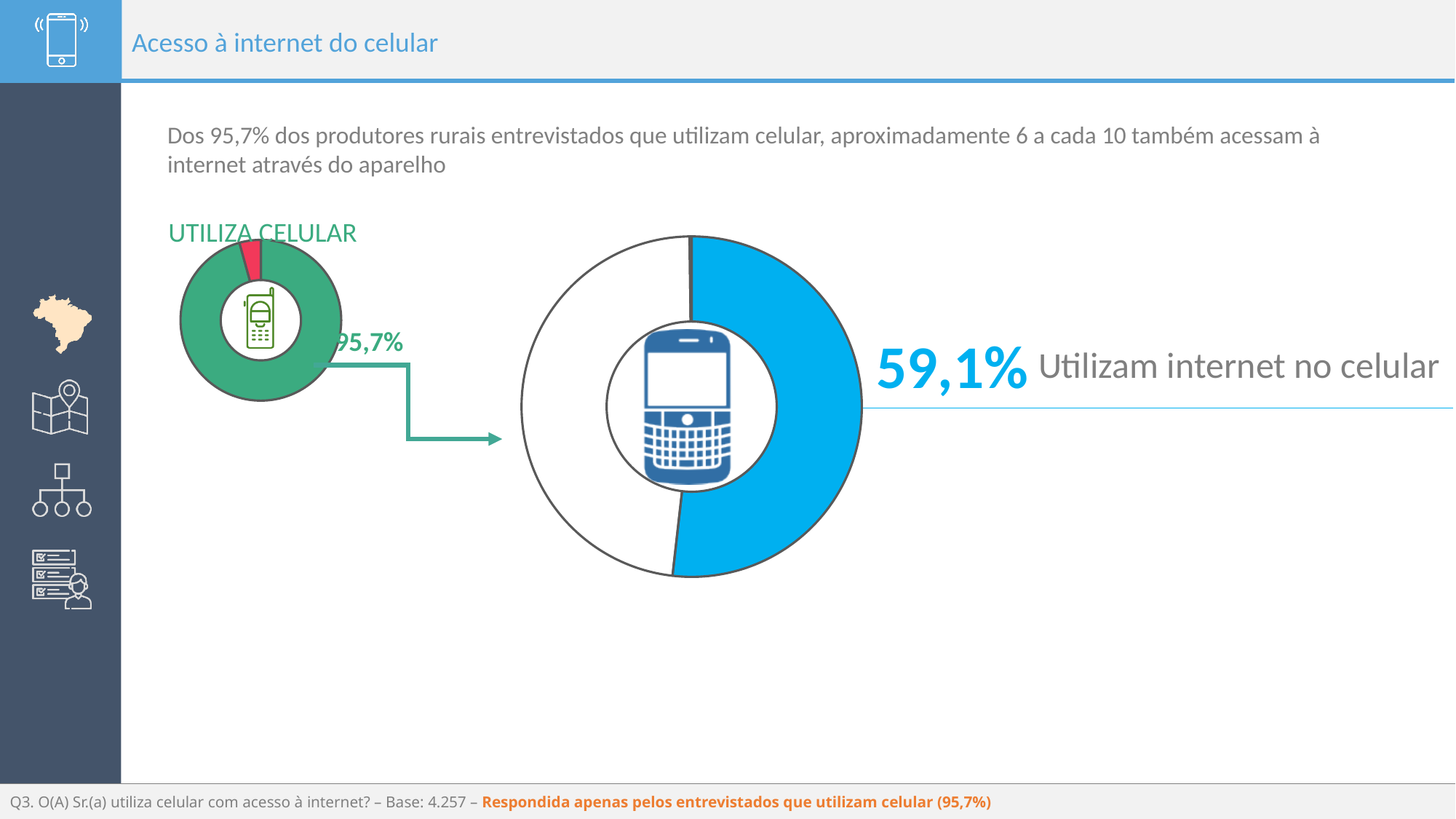
What kind of chart is the small chart titled 'UTILIZA CELULAR'? Donut (pie) chart How many slices does the small 'UTILIZA CELULAR' donut chart have? 2 In the large donut chart on the right, which slice is larger: the blue slice or the white slice? The blue slice What is the title of the small donut chart on the left? UTILIZA CELULAR What share of the large donut chart on the right does the blue slice represent? 59,1% What colour is the slice representing 59,1% in the large donut chart on the right? Blue In the large donut chart on the right, what percentage is shown for 'Utilizam internet no celular'? 59,1% What is the difference between the 95,7% shown in the 'UTILIZA CELULAR' chart and the 59,1% shown in the large chart on the right? 36,6% In the small donut chart titled 'UTILIZA CELULAR', what percentage is shown for the green slice? 95,7% How many slices does the large donut chart on the right have? 2 What kind of chart is the large chart on the right of the slide? Donut (pie) chart Which value is larger: the 'UTILIZA CELULAR' percentage or the 'Utilizam internet no celular' percentage? UTILIZA CELULAR (95,7%)